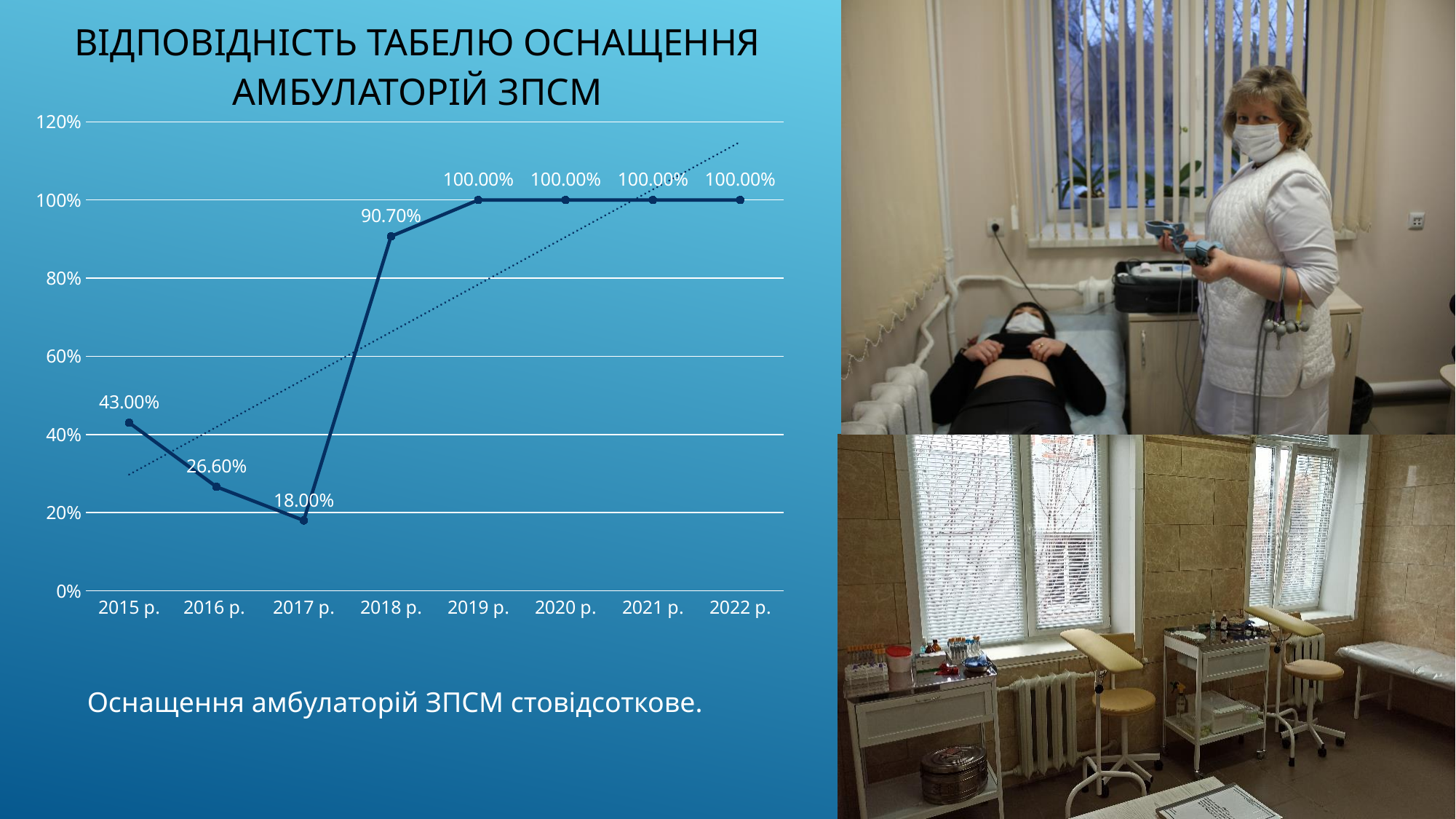
What type of chart is shown on the slide? line chart What is the value for 2016 р.? 26.60% What is the value for 2017 р.? 18.00% Which year has the lowest value? 2017 р. What is the title of the chart? ВІДПОВІДНІСТЬ ТАБЕЛЮ ОСНАЩЕННЯ АМБУЛАТОРІЙ ЗПСМ Do the values rise or fall from 2017 р. to 2019 р.? rise Which is larger, the value for 2015 р. or the value for 2016 р.? 2015 р. How many years are plotted on the x axis? 8 What is the difference between the values for 2018 р. and 2017 р.? 72.70% What is the value for 2015 р.? 43.00% What is the difference between the values for 2015 р. and 2016 р.? 16.40% What is the value for 2018 р.? 90.70%